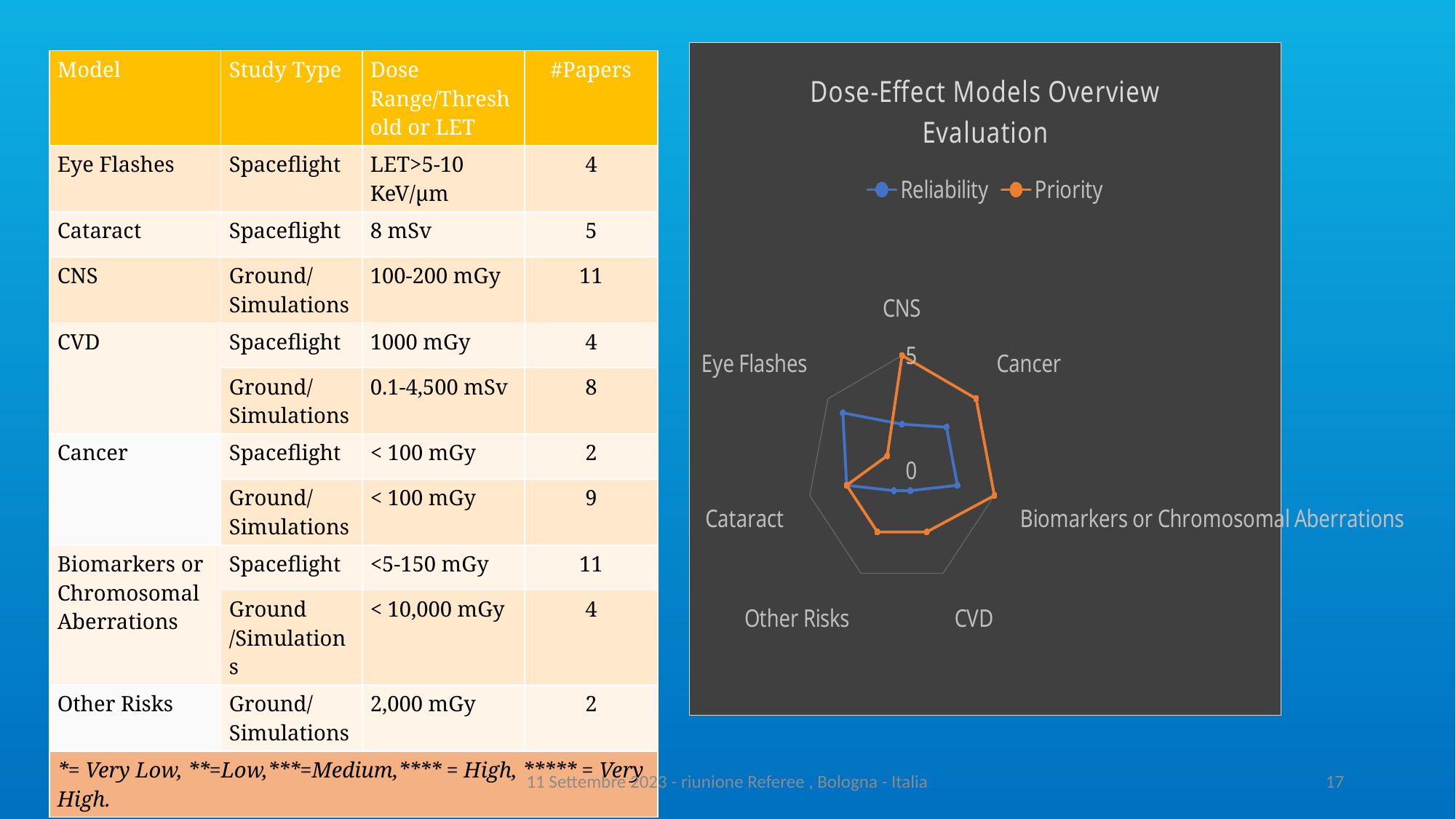
How many categories are plotted on the radar chart? 7 Which category has the lowest Priority value? Eye Flashes What is the Priority value for CNS? 5 Which category has the highest Priority value? CNS, Cancer and Biomarkers or Chromosomal Aberrations (tied at 5) For Eye Flashes, which is larger: Reliability or Priority? Reliability How many series does the chart legend list? 2 Is the Reliability value for CNS greater or less than 5? less Which category has the highest Reliability value? Eye Flashes For CNS, which is larger: Reliability or Priority? Priority What is the title of the chart? Dose-Effect Models Overview Evaluation What kind of chart is shown on the slide? Radar chart Which colour represents the Priority series in the chart? Orange